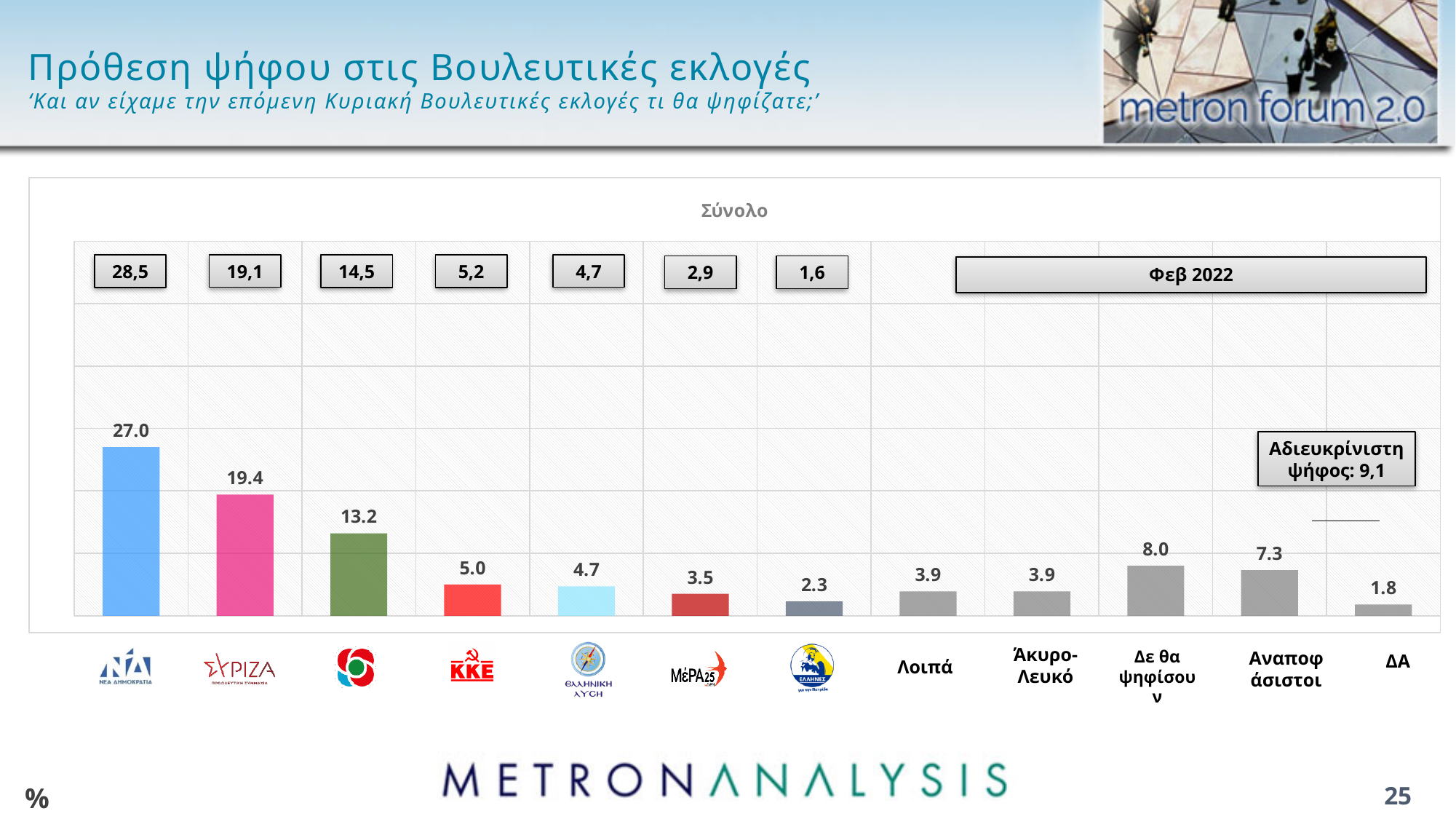
Which category has the lowest value in the chart? ΔΑ What kind of chart is shown on the slide? bar chart Which is larger, the value for Δε θα ψηφίσουν or the value for Αναποφάσιστοι? Δε θα ψηφίσουν What is the Φεβ 2022 value shown above the ΝΕΑ ΔΗΜΟΚΡΑΤΙΑ bar? 28,5 What is the difference between the values for ΝΕΑ ΔΗΜΟΚΡΑΤΙΑ and ΣΥΡΙΖΑ? 7.6 What is the value for ΝΕΑ ΔΗΜΟΚΡΑΤΙΑ in the chart? 27.0 What is the value for ΣΥΡΙΖΑ in the chart? 19.4 What is the value for Δε θα ψηφίσουν in the chart? 8.0 What is the value for ΜέΡΑ25 in the chart? 3.5 What is the value for ΚΚΕ in the chart? 5.0 Which category has the highest value in the chart? ΝΕΑ ΔΗΜΟΚΡΑΤΙΑ How many categories are shown in the chart? 12